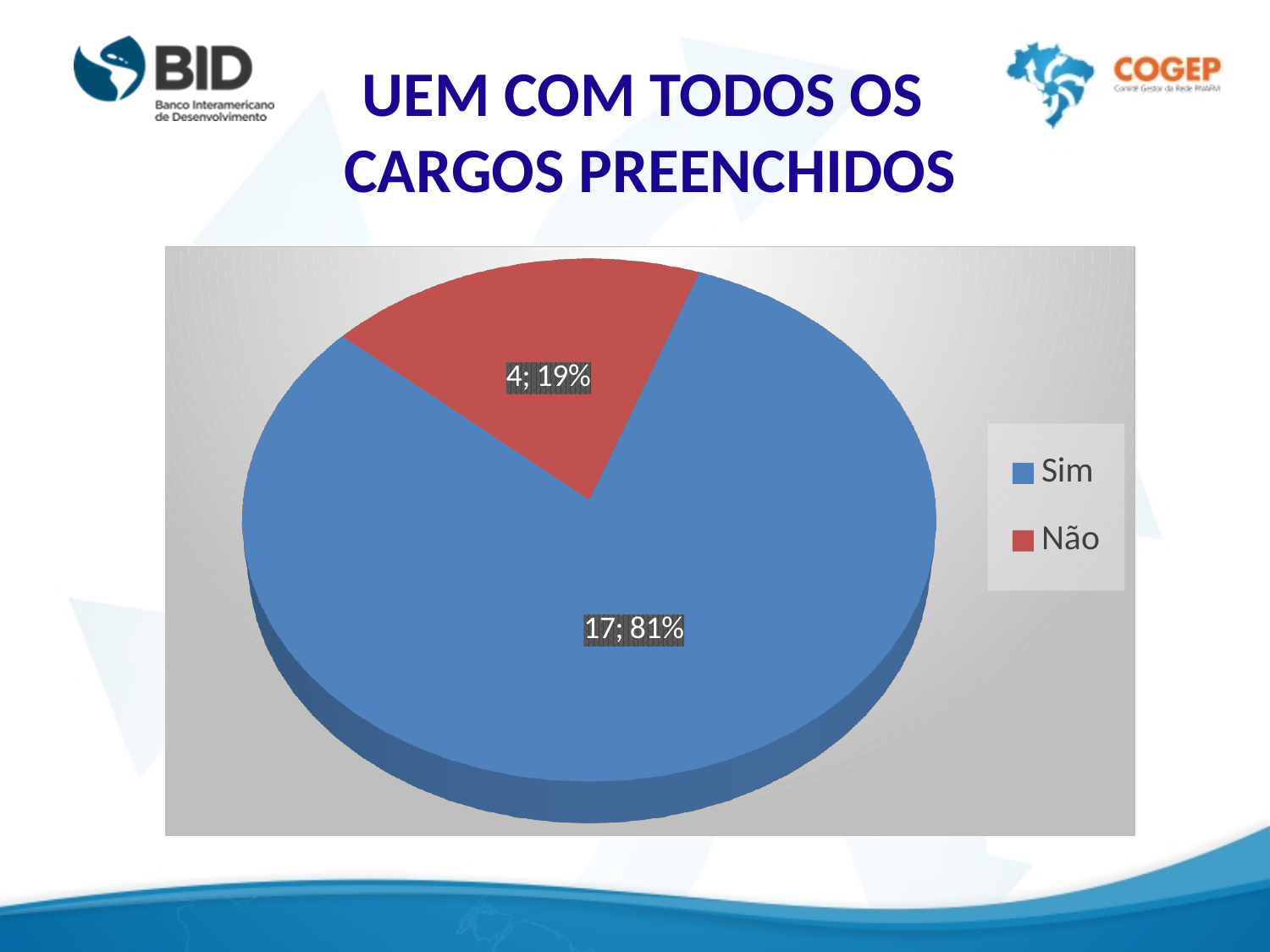
How many UEMs answered "Não" according to the pie chart? 4 What kind of chart is shown on the slide? pie chart What is the difference between the count for "Sim" and the count for "Não"? 13 Which category has the largest slice of the pie? Sim What colour is the "Não" slice in the pie chart? red What share of the pie does the "Não" slice represent? 19% What share of the pie does the "Sim" slice represent? 81% Which is larger, the "Sim" slice or the "Não" slice? Sim Which category has the smallest slice of the pie? Não What is the total of the counts shown in the pie chart? 21 How many categories does the pie chart show? 2 How many UEMs answered "Sim" according to the pie chart? 17